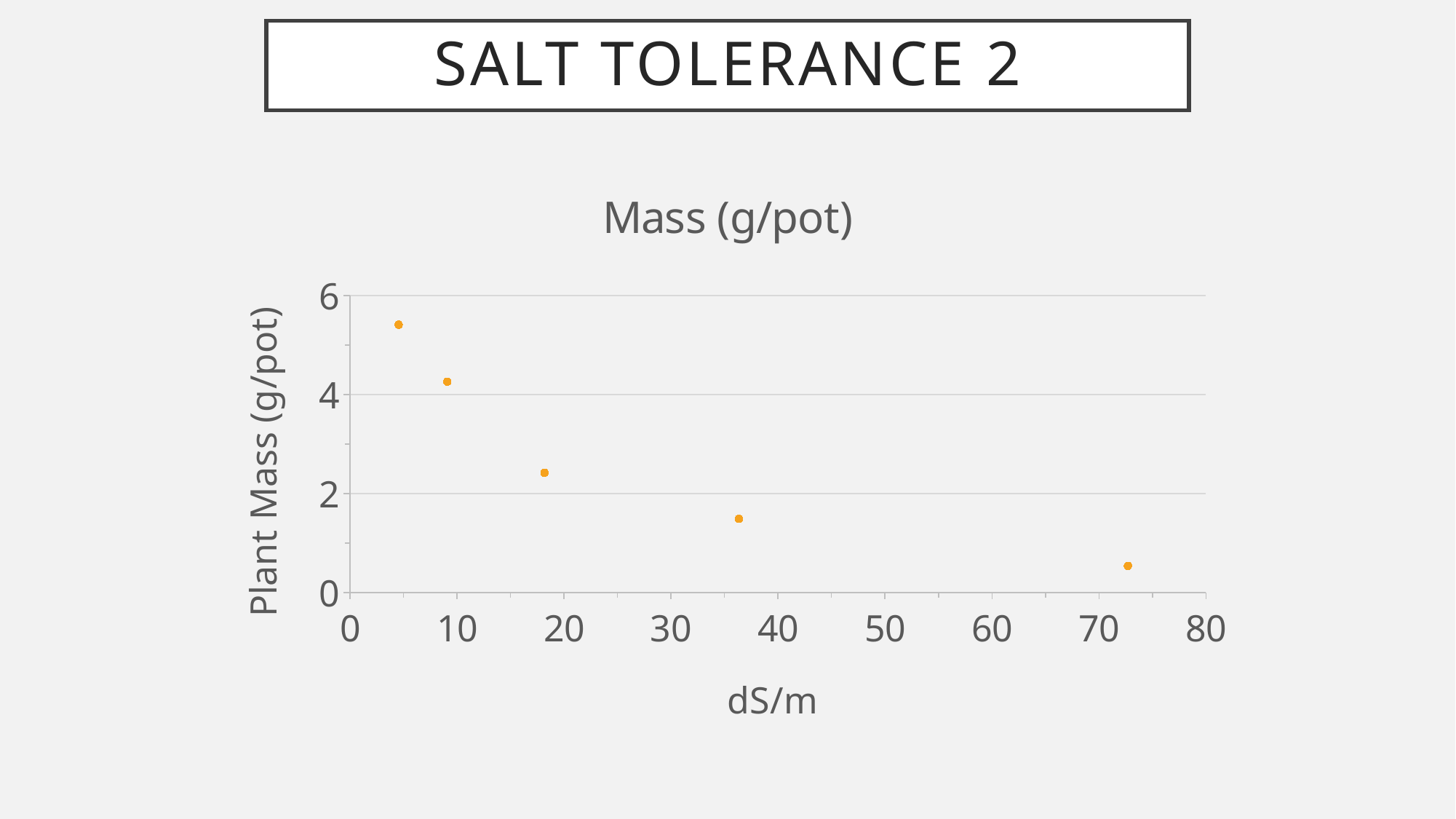
Is the plant mass of the point near 36 dS/m greater or less than 2? less Is the plant mass of the point near 18 dS/m greater or less than 2? greater What is the title of the chart? Mass (g/pot) Do the plotted plant mass values rise or fall as dS/m increases along the x axis? fall Is the plant mass of the point near 36 dS/m greater or less than 1? greater What is the label on the vertical axis of the chart? Plant Mass (g/pot) How many data points are plotted on the chart? 5 Which point has the highest plant mass: the one near 5 dS/m or the one near 73 dS/m? the one near 5 dS/m What kind of chart is shown on the slide? scatter chart